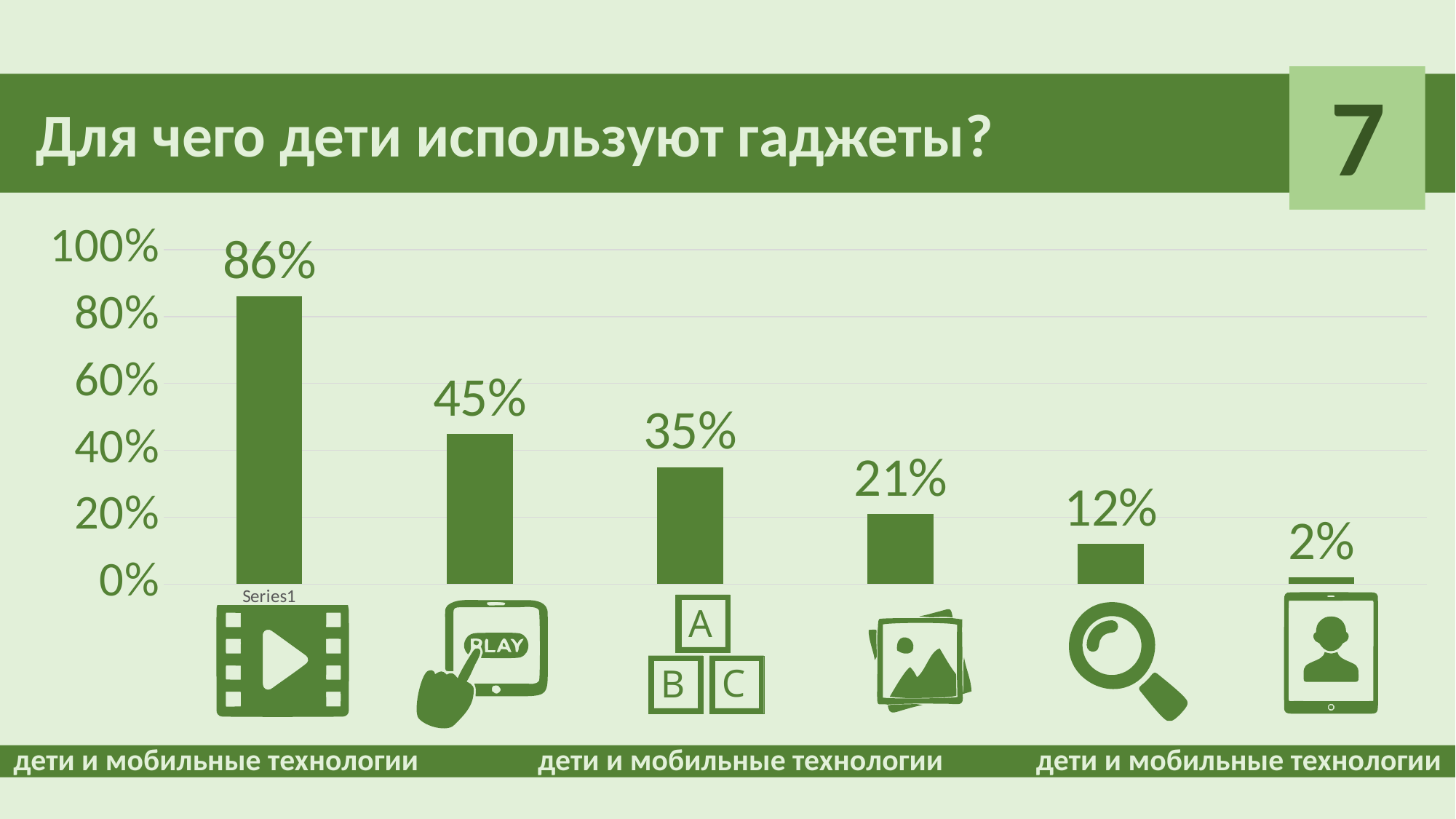
What is the value of the last (rightmost) bar, above the video-call icon? 2% What is the value of the fourth bar, above the photos icon? 21% How many bars are plotted in the chart? 6 What is the value of the fifth bar, above the magnifying-glass icon? 12% What is the value of the first (leftmost) bar, above the film-strip icon? 86% Do the bar values rise or fall from left to right? fall What is the value of the second bar, above the 'PLAY' tablet icon? 45% What is the difference between the first bar (86%) and the second bar (45%)? 41% What type of chart is shown on the slide? bar chart What is the title of the slide containing the chart? Для чего дети используют гаджеты? Which bar has the highest value? the first bar (film-strip icon), 86% What is the value of the third bar, above the ABC blocks icon? 35%